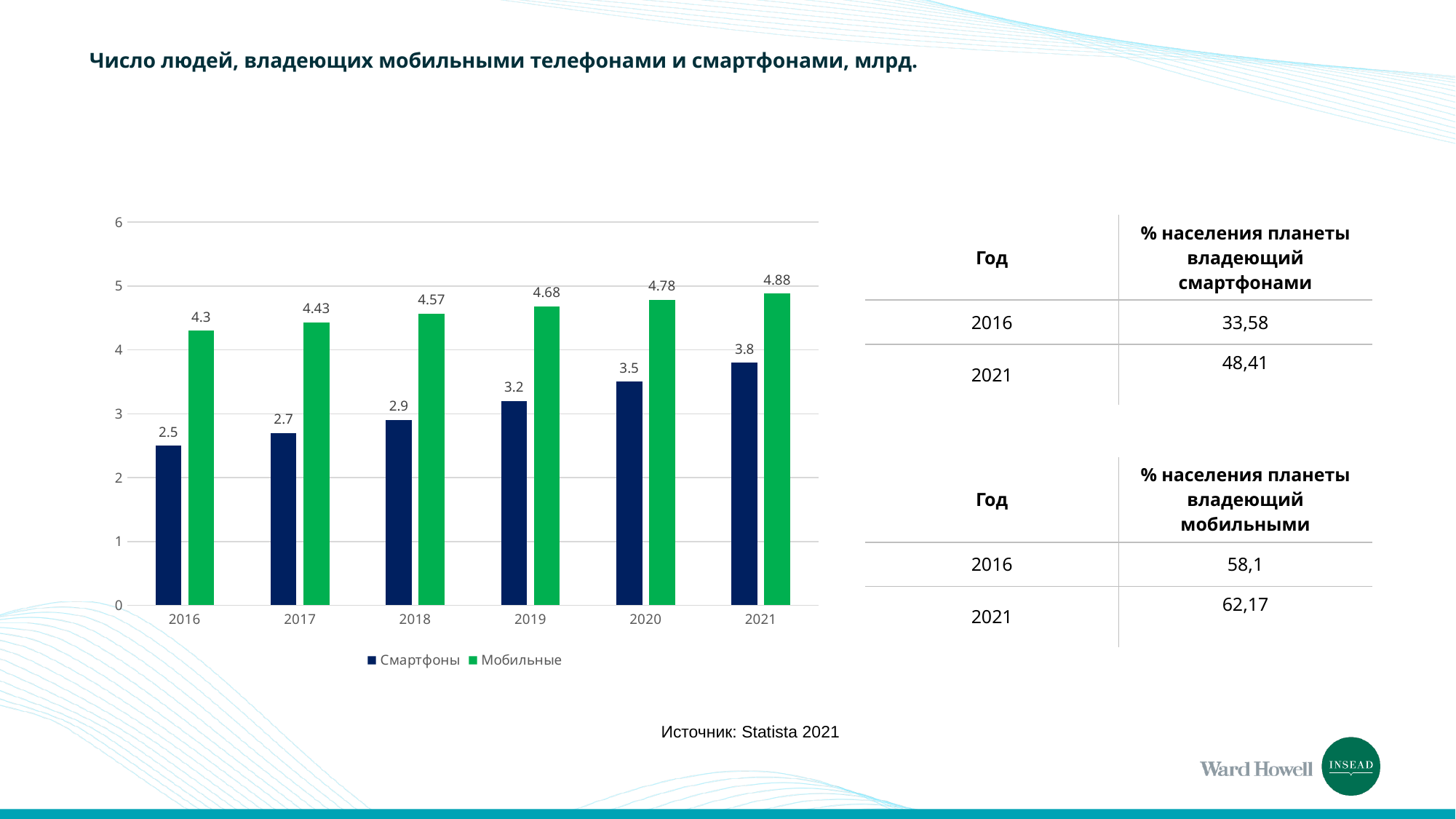
What is the value for Мобильные in 2018? 4.57 How many years are shown on the x axis? 6 What kind of chart is shown? bar chart Do the Смартфоны values rise or fall from 2016 to 2021? rise What is the value for Мобильные in 2021? 4.88 Which year has the lowest value for Мобильные? 2016 Which is larger in 2019: Смартфоны or Мобильные? Мобильные How many series does the legend list? 2 Which year has the highest value for Смартфоны? 2021 Is the value for Смартфоны in 2021 greater or less than 4? less What is the value for Смартфоны in 2016? 2.5 What is the difference between the Мобильные and Смартфоны values in 2020? 1.28